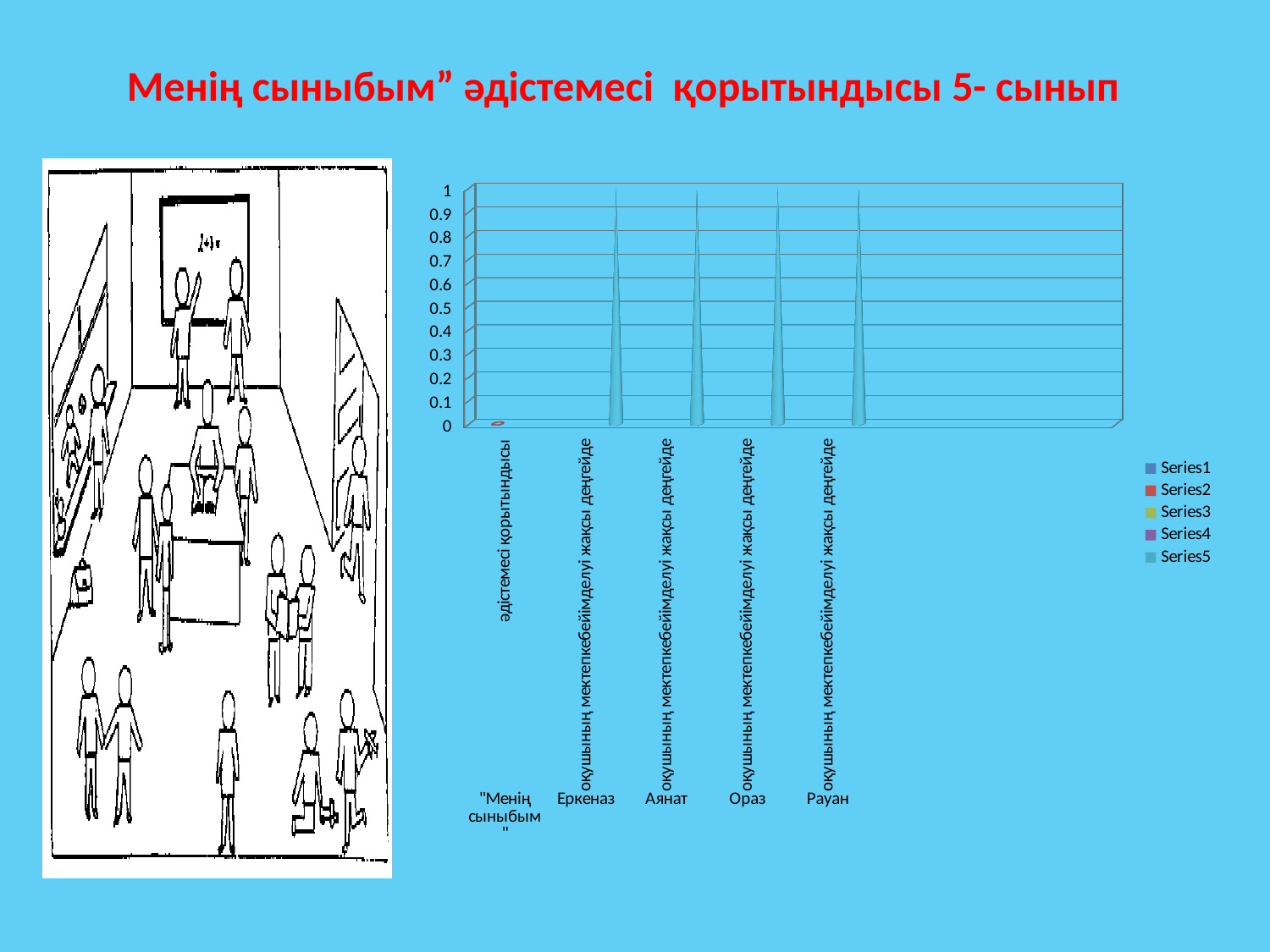
What kind of chart is shown on the slide? bar chart Is the value for Ораз greater or less than 0.5? greater Is the value for Рауан greater or less than 0.5? greater How many categories are shown on the x axis of the chart? 5 Which category has the lowest value in the chart? "Менің сыныбым" Is the value for "Менің сыныбым" greater or less than 0.5? less What is the highest value shown on the chart's vertical axis? 1 Which is larger, the value for Еркеназ or the value for "Менің сыныбым"? Еркеназ What is the name of the last series listed in the chart legend? Series5 How many series does the chart legend list? 5